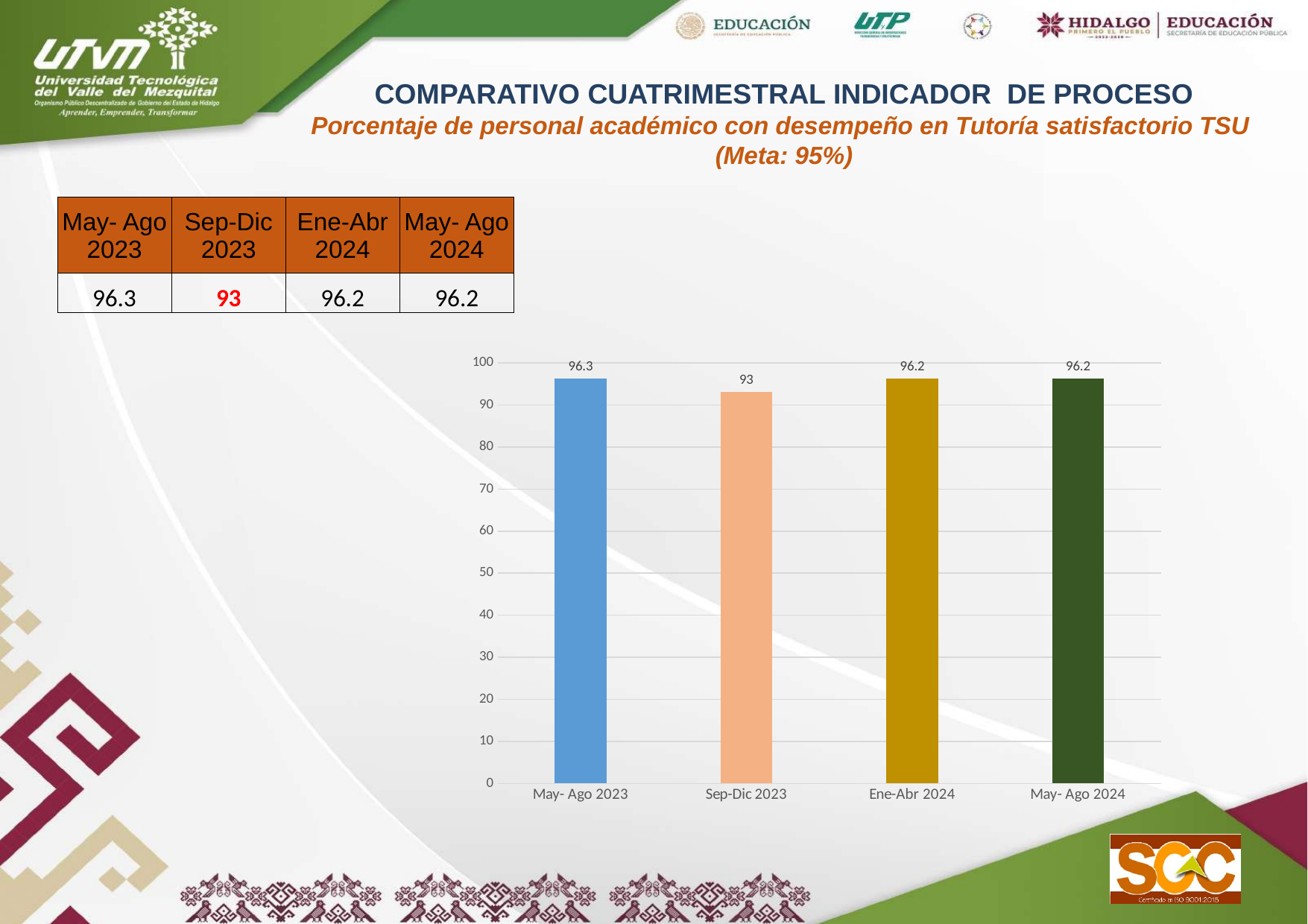
Is the value for Sep-Dic 2023 greater or less than 90? greater How many periods are shown on the x axis of the chart? 4 What kind of chart is shown on the slide? bar chart Which is larger, the value for Sep-Dic 2023 or the value for May- Ago 2024? May- Ago 2024 What is the target (Meta) stated in the slide title? 95% What is the value for May- Ago 2023? 96.3 What is the difference between the values for May- Ago 2023 and Sep-Dic 2023? 3.3 What is the value for Sep-Dic 2023? 93 Which period has the highest value? May- Ago 2023 What is the difference between the values for Ene-Abr 2024 and Sep-Dic 2023? 3.2 What is the value for Ene-Abr 2024? 96.2 Which period has the lowest value? Sep-Dic 2023